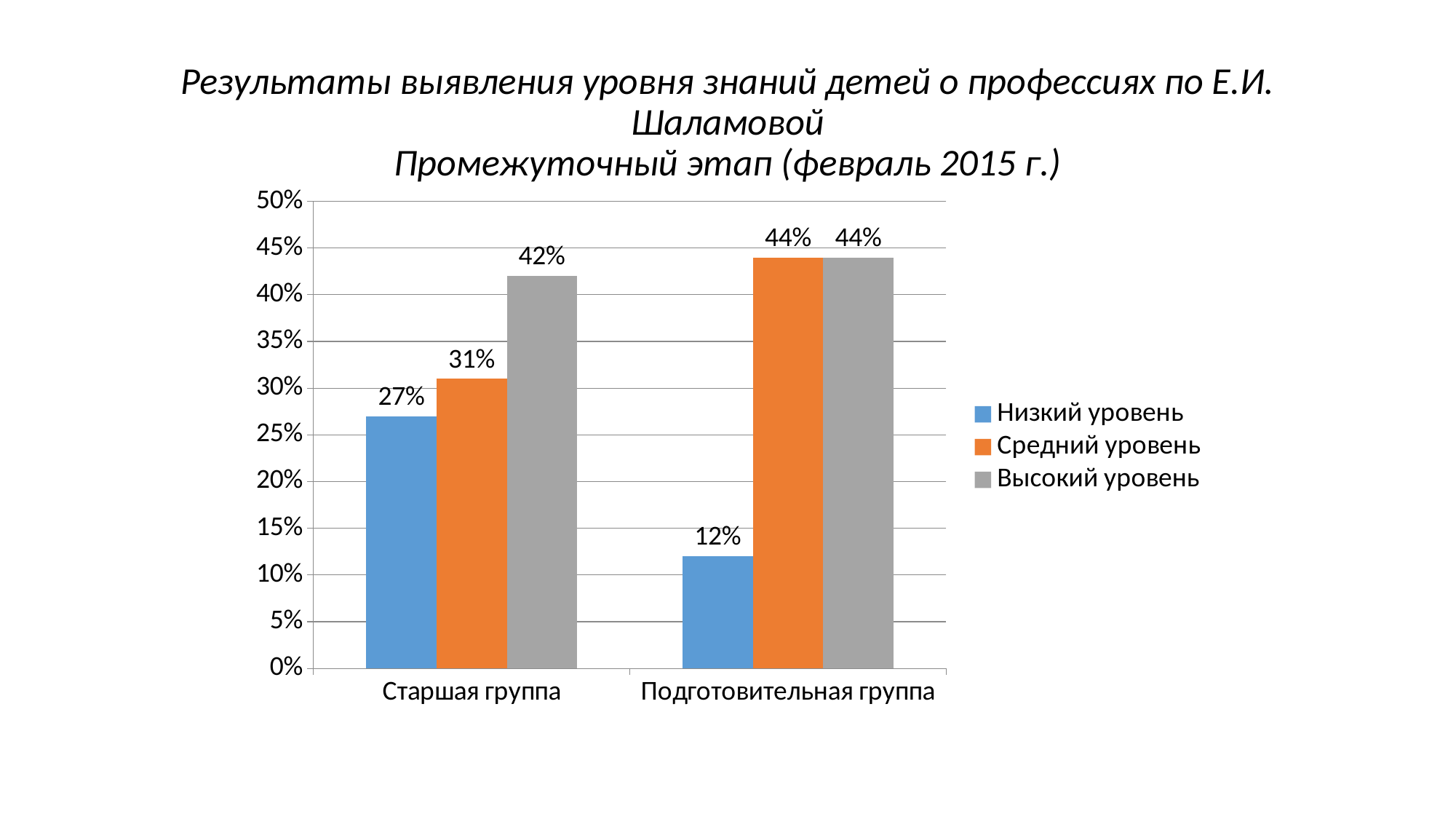
What is the value for Средний уровень in Подготовительная группа? 44% Which level has the highest value in Старшая группа? Высокий уровень How many groups (categories) are shown on the x axis? 2 What kind of chart is shown on the slide? Bar chart What is the value for Высокий уровень in Старшая группа? 42% What is the difference between Низкий уровень in Старшая группа and Низкий уровень in Подготовительная группа? 15% What is the value for Низкий уровень in Старшая группа? 27% How many series does the legend list? 3 Which is larger: Средний уровень in Старшая группа or Средний уровень in Подготовительная группа? Подготовительная группа Which colour represents Средний уровень in the legend? Orange What is the value for Низкий уровень in Подготовительная группа? 12% Which level has the lowest value in Подготовительная группа? Низкий уровень